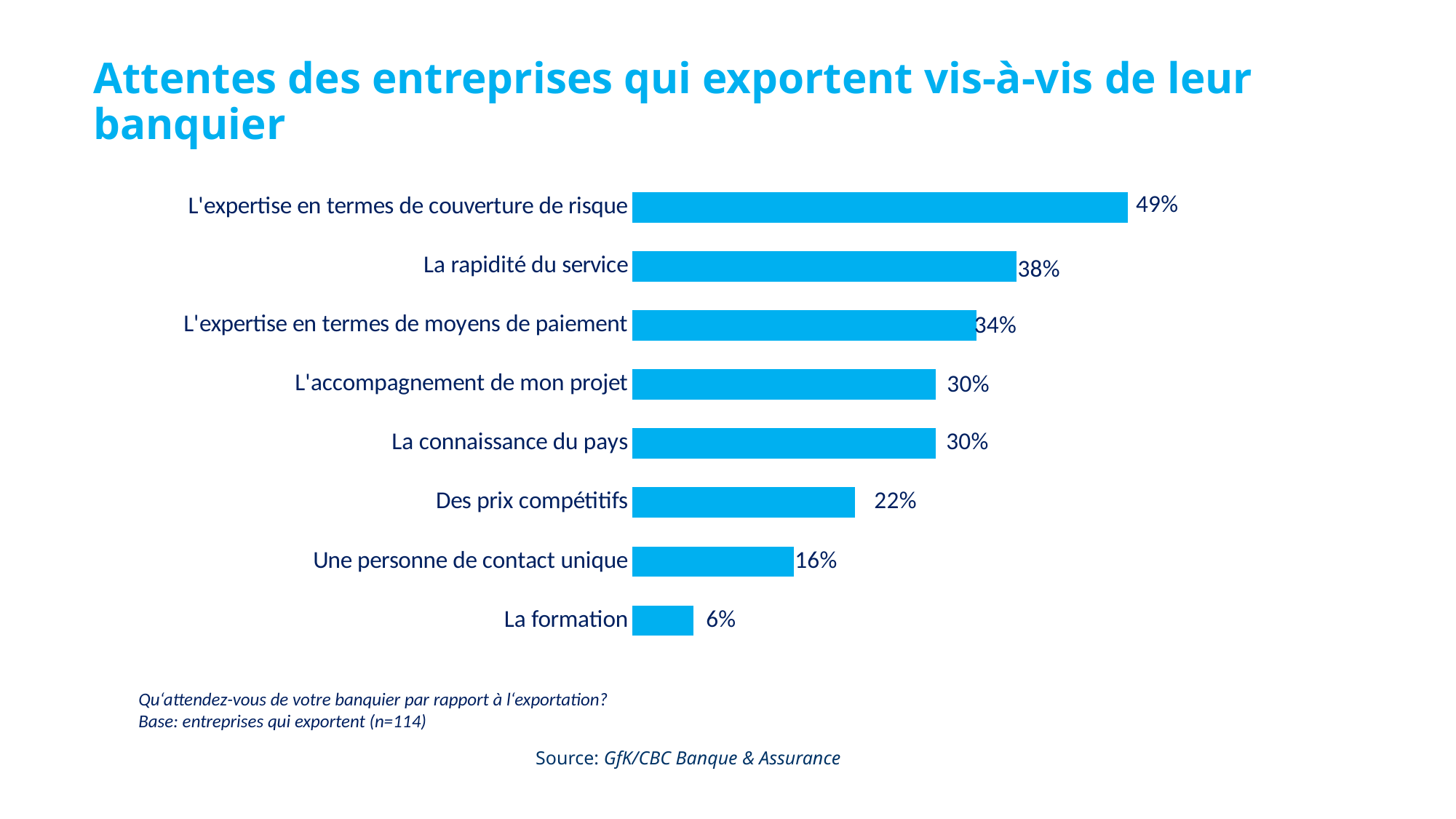
What is the value for "La rapidité du service"? 38% Which is larger, the value for "Des prix compétitifs" or the value for "Une personne de contact unique"? Des prix compétitifs Which category has the highest value? L'expertise en termes de couverture de risque Which category has the lowest value? La formation What is the difference between the values for "L'expertise en termes de couverture de risque" and "La formation"? 43% What is the value for "Une personne de contact unique"? 16% What kind of chart is shown on the slide? Bar chart What is the title of the slide? Attentes des entreprises qui exportent vis-à-vis de leur banquier How many categories are shown in the chart? 8 What is the difference between the values for "La rapidité du service" and "L'expertise en termes de moyens de paiement"? 4% What is the value for "L'expertise en termes de couverture de risque"? 49% What is the value for "Des prix compétitifs"? 22%